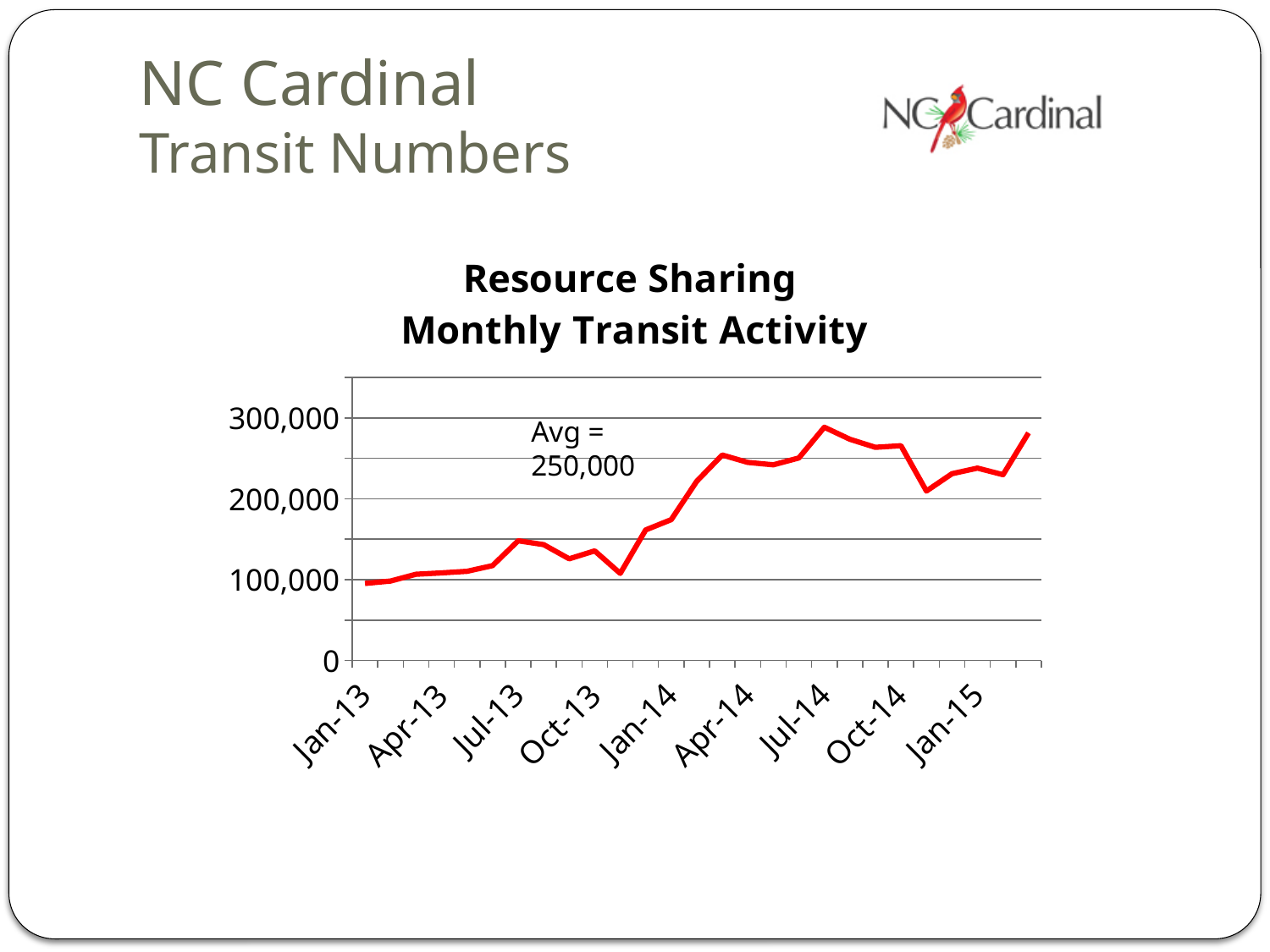
Is the value for Apr-13 greater or less than 150,000? less Is the value for Oct-13 greater or less than 150,000? less How many month labels are shown on the x axis? 9 What average value is annotated on the chart? Avg = 250,000 Overall, do the monthly transit values rise or fall from Jan-13 to the end of the series? rise Is the value for Jan-14 greater or less than 100,000? greater What is the title of the chart? Resource Sharing Monthly Transit Activity Which is larger, the value for Jul-14 or the value for Jan-13? Jul-14 What kind of chart is shown on the slide? line chart Which labelled month on the x axis has the highest transit value? Jul-14